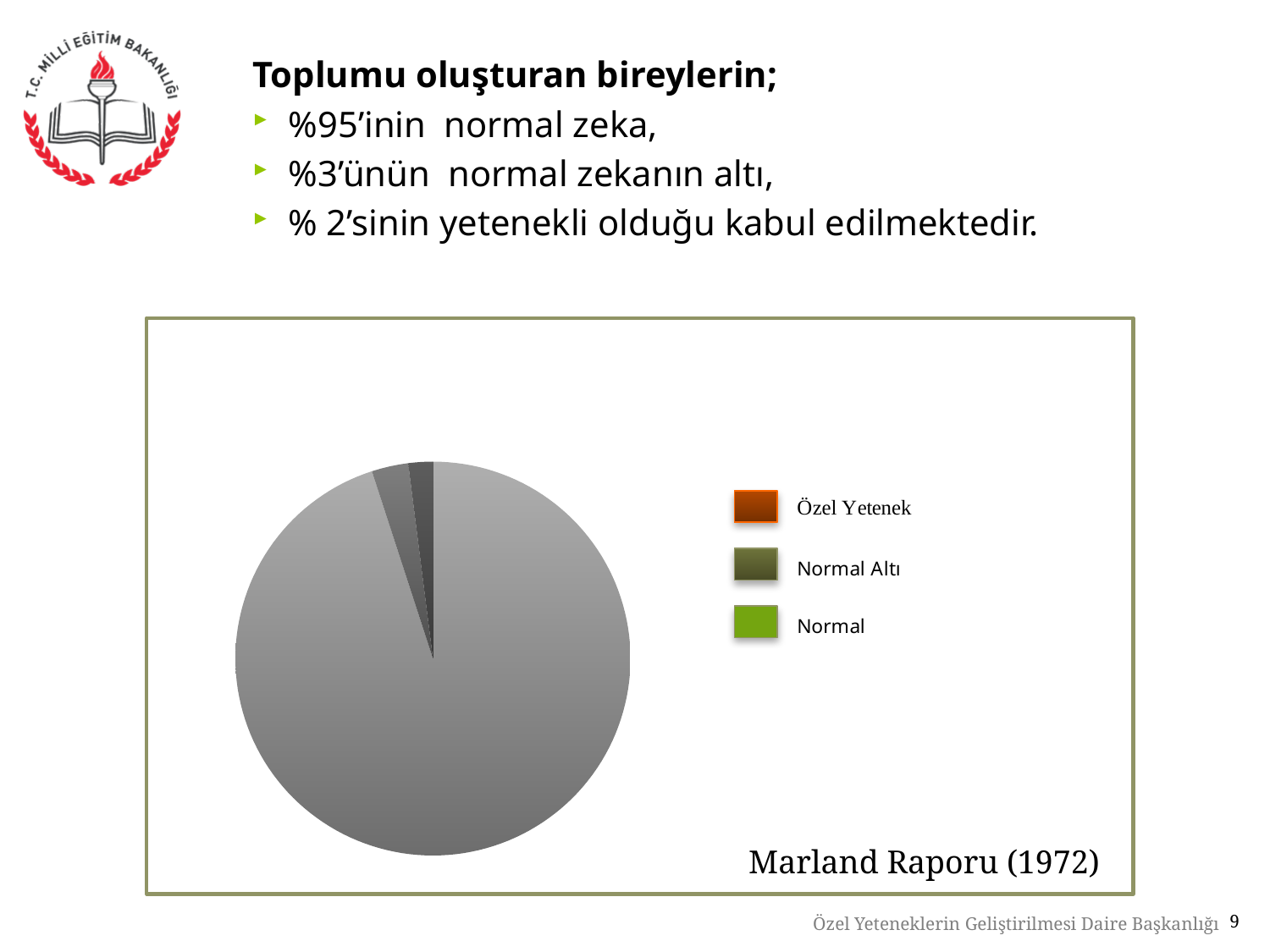
Which category has the largest slice in the pie chart? Normal Which slice is larger in the pie chart, Normal or Normal Altı? Normal How many entries does the legend of the pie chart list? 3 Which slice is larger in the pie chart, Normal or Özel Yetenek? Normal What kind of chart is shown on the slide? pie chart What are the three legend entries of the pie chart? Özel Yetenek, Normal Altı, Normal Does the Normal slice take up more or less than half of the pie chart? more How many slices does the pie chart have? 3 What source is cited in the bottom right corner of the chart area? Marland Raporu (1972)